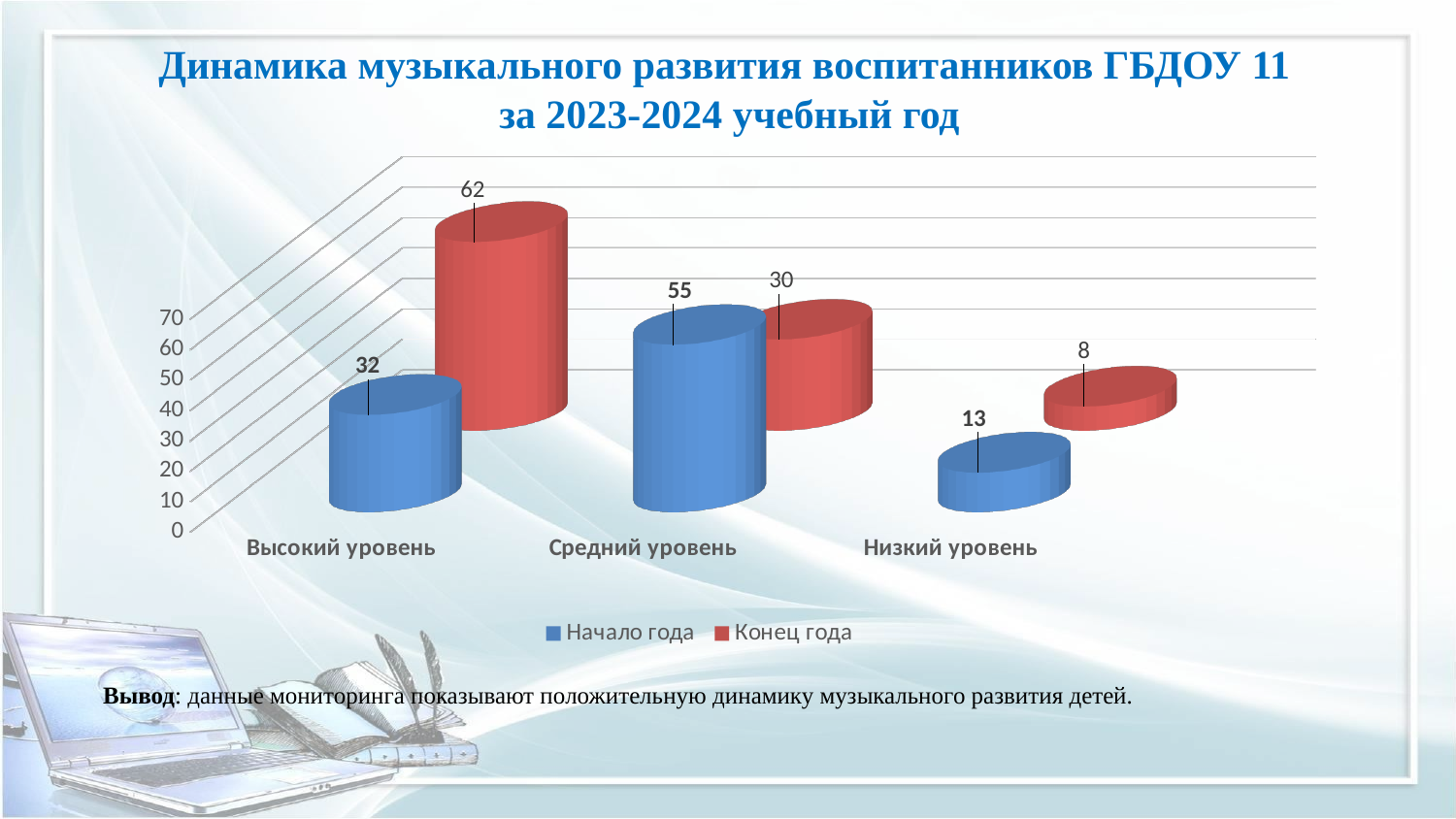
What is the value for Начало года in the Высокий уровень category? 32 Which colour represents the Конец года series? Red Which category has the lowest value for the Начало года series? Низкий уровень Which category has the highest value for the Конец года series? Высокий уровень What kind of chart is shown on the slide? Bar chart What is the difference between the Конец года and Начало года values for Высокий уровень? 30 Which is larger for Средний уровень: the Начало года value or the Конец года value? Начало года How many series does the legend list? 2 How many categories are shown on the x axis? 3 What is the value for Начало года in the Средний уровень category? 55 What is the value for Конец года in the Низкий уровень category? 8 What is the value for Конец года in the Высокий уровень category? 62